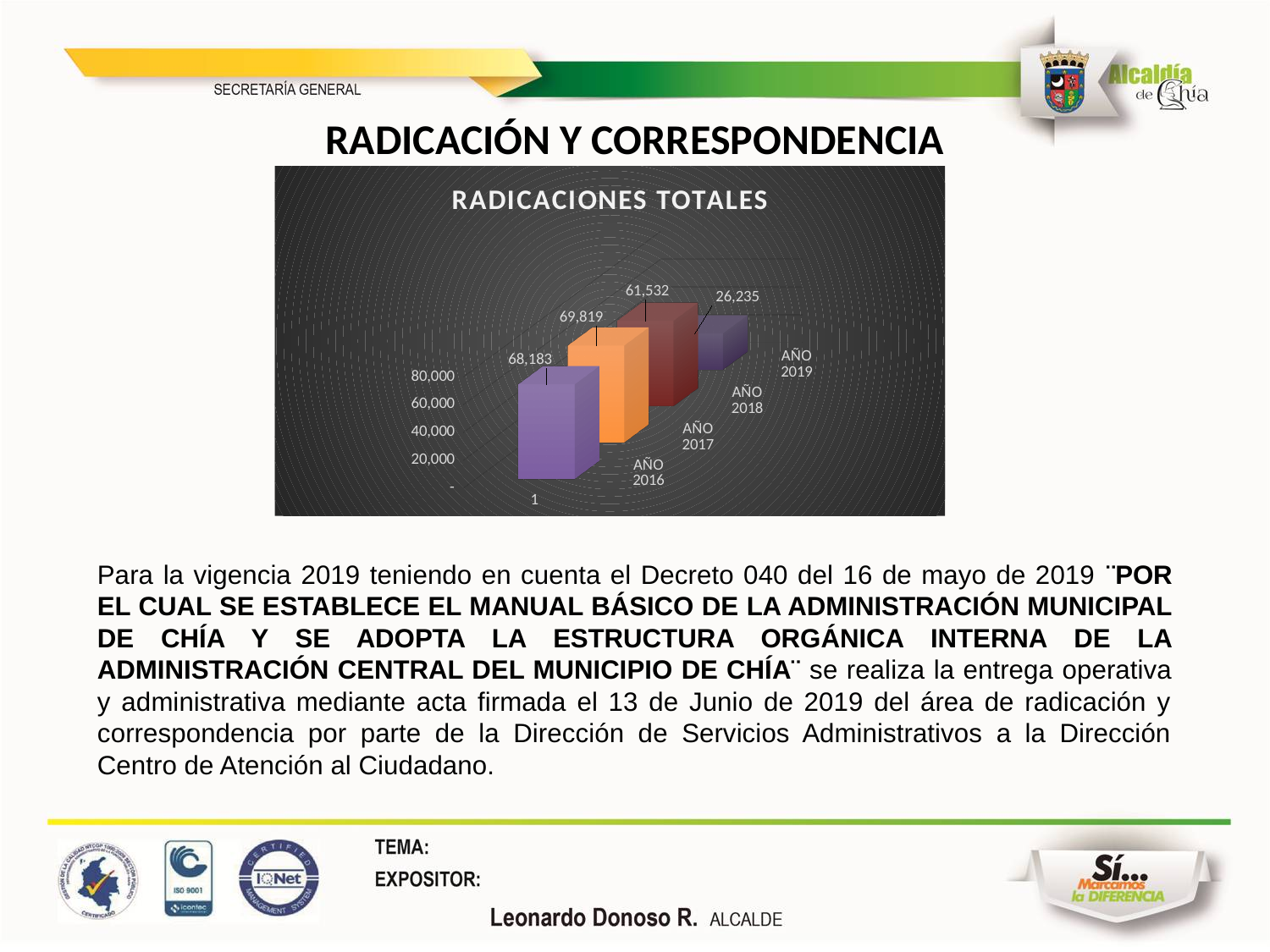
What is the title of the chart? RADICACIONES TOTALES Which year has the highest value? AÑO 2017 What is the value for AÑO 2017? 69,819 What is the value for AÑO 2019? 26,235 What type of chart is shown on the slide? bar chart Which year has the lowest value? AÑO 2019 What is the difference between the values for AÑO 2017 and AÑO 2016? 1,636 Which is larger, the value for AÑO 2016 or the value for AÑO 2018? AÑO 2016 What is the value for AÑO 2016? 68,183 What is the difference between the values for AÑO 2018 and AÑO 2019? 35,297 What is the value for AÑO 2018? 61,532 How many years are plotted in the chart? 4